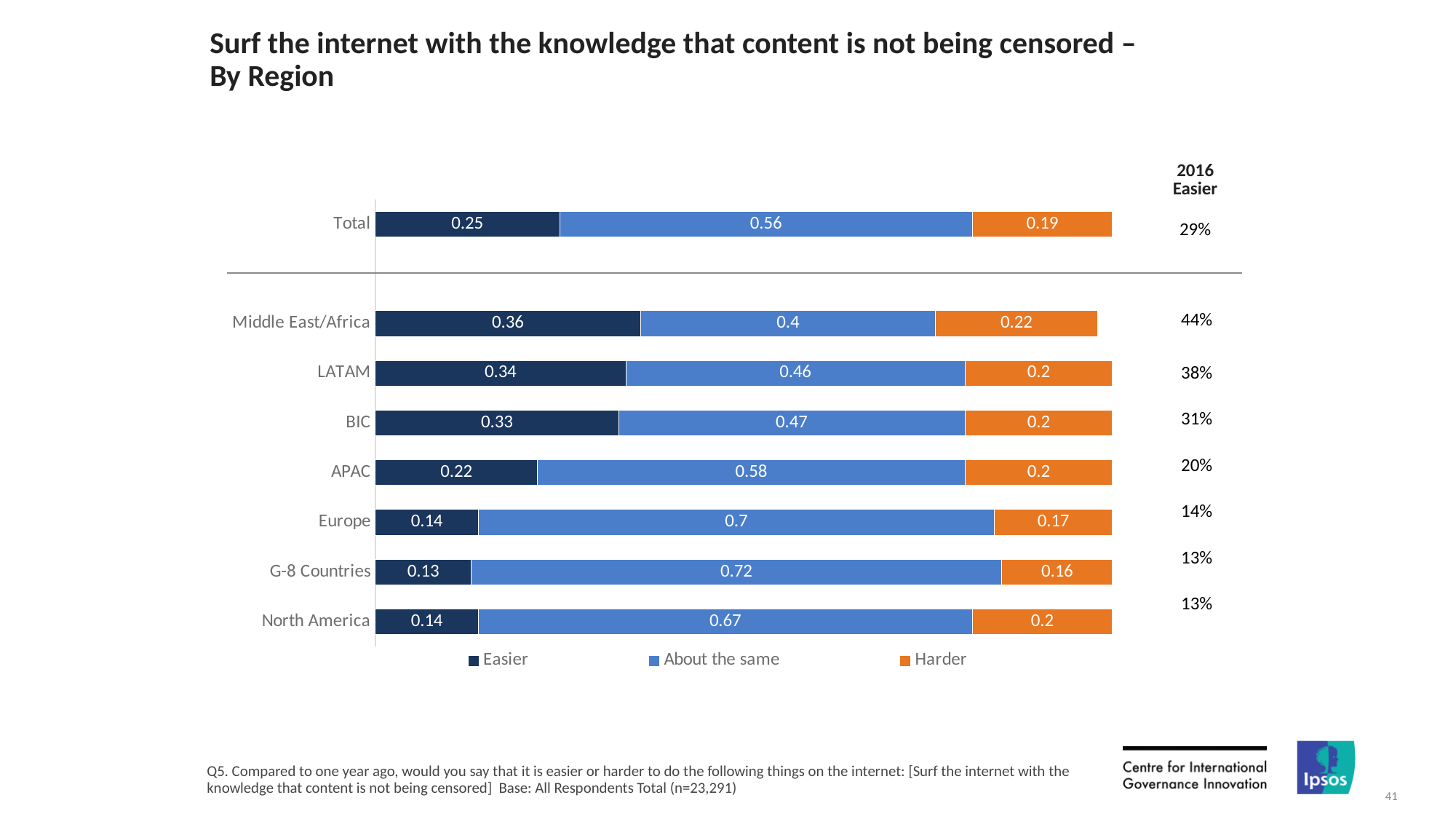
What is the 'Harder' value for Europe? 0.17 What is the difference between the 'About the same' values for Europe and APAC? 0.12 Which is larger, the 'Easier' value for LATAM or for BIC? LATAM What is the 'About the same' value for G-8 Countries? 0.72 How many region categories are plotted, including Total? 8 What is the total of the stacked bar for Total? 1 Which region has the highest 'Easier' value? Middle East/Africa Which region has the lowest 'Easier' value? G-8 Countries What kind of chart is shown on the slide? Stacked bar chart How many series does the legend list? 3 What is the 'Easier' value for Middle East/Africa? 0.36 What is the 2016 Easier percentage shown for APAC? 20%